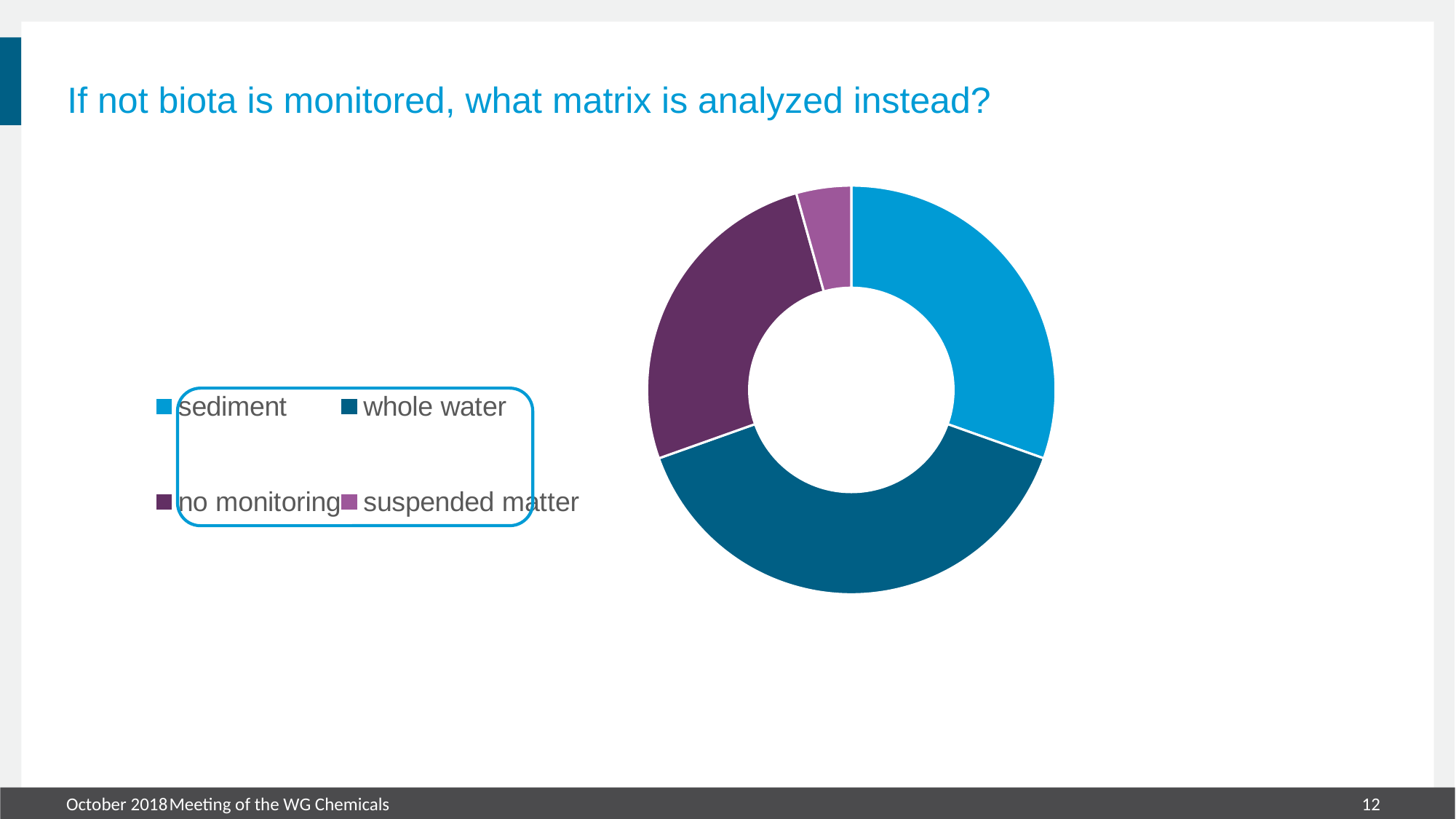
Which slice is larger, no monitoring or suspended matter? no monitoring Which slice is larger, whole water or no monitoring? whole water How many entries does the legend list? 4 Which slice is larger, sediment or suspended matter? sediment Which category has the smallest slice of the chart? suspended matter What is the title of the slide containing the chart? If not biota is monitored, what matrix is analyzed instead? Which category has the largest slice of the chart? whole water What kind of chart is shown on the slide? doughnut chart How many categories does the chart show? 4